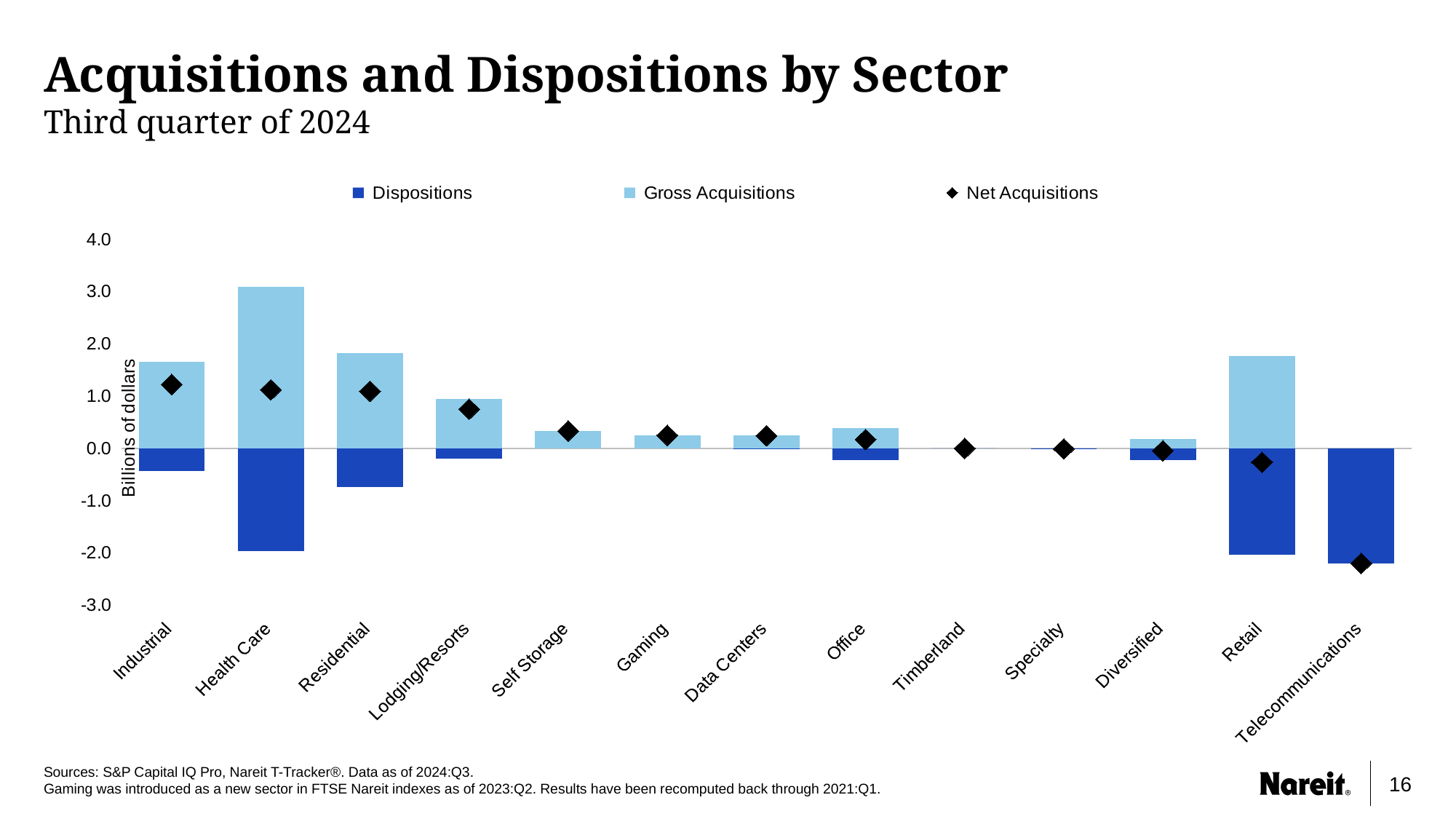
Which sector has larger Gross Acquisitions, Industrial or Lodging/Resorts? Industrial Is the Gross Acquisitions value for Health Care greater or less than 2.0? greater What is the label on the vertical axis of the chart? Billions of dollars Which sector has the highest Gross Acquisitions? Health Care How many sectors are shown on the x axis of the chart? 13 How many series does the chart's legend list? 3 Which sector has higher Net Acquisitions, Lodging/Resorts or Self Storage? Lodging/Resorts Is the Net Acquisitions value for Telecommunications greater or less than -2.0? less What kind of chart is shown on the slide? bar chart Is the Dispositions value for Residential greater or less than -0.5? less Which sector has the lowest Net Acquisitions? Telecommunications